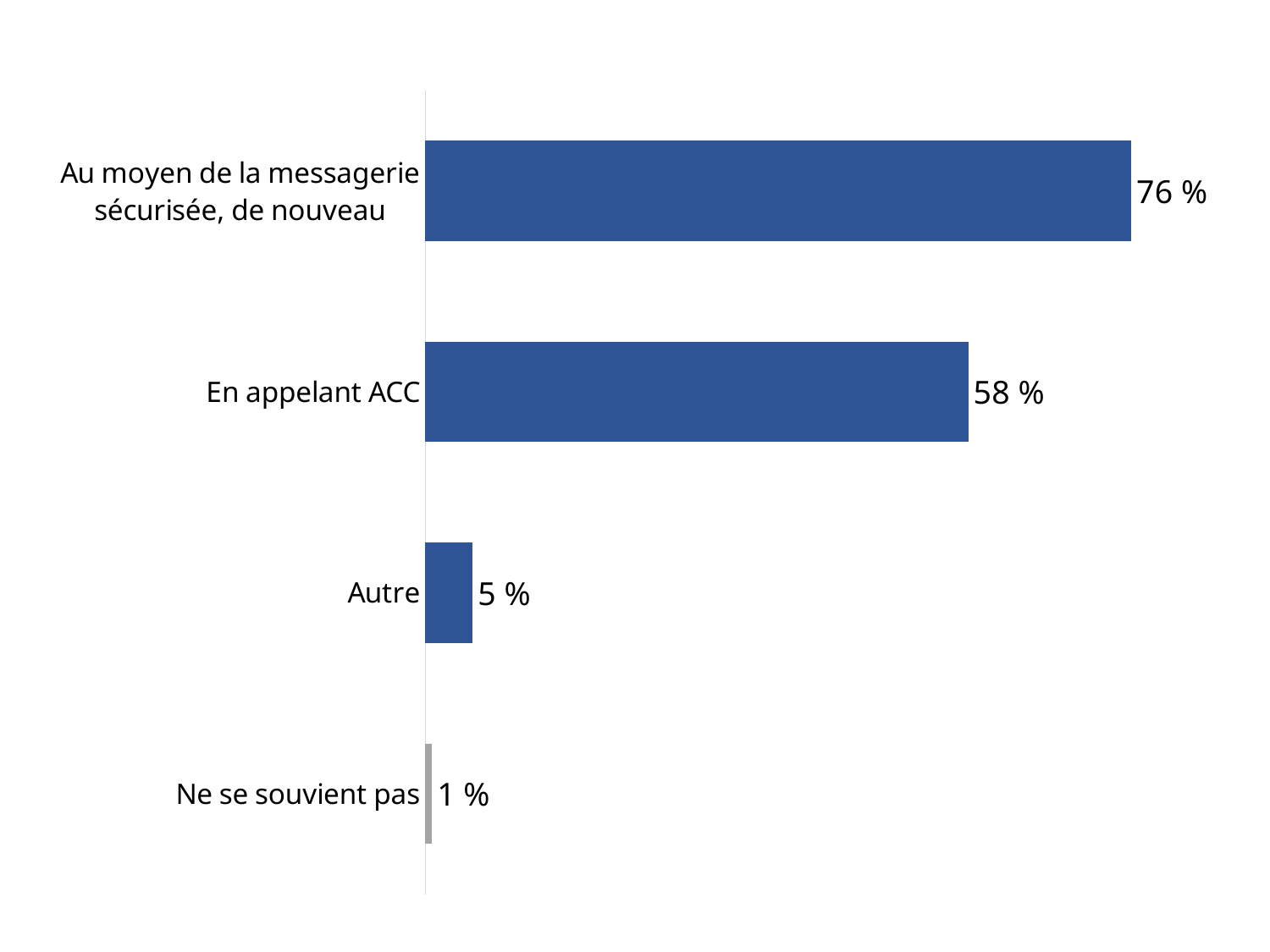
What is the value for "Au moyen de la messagerie sécurisée, de nouveau"? 76 % What is the value for "Ne se souvient pas"? 1 % What is the difference between the values for "Autre" and "Ne se souvient pas"? 4 % Which category has the lowest value? Ne se souvient pas What is the value for "En appelant ACC"? 58 % Which bar is shown in a different colour (grey) from the others? Ne se souvient pas Which is larger, the value for "En appelant ACC" or the value for "Autre"? En appelant ACC Which category has the highest value? Au moyen de la messagerie sécurisée, de nouveau What is the difference between the values for "Au moyen de la messagerie sécurisée, de nouveau" and "En appelant ACC"? 18 % How many categories are shown in the chart? 4 What kind of chart is shown on the slide? Bar chart What is the value for "Autre"? 5 %